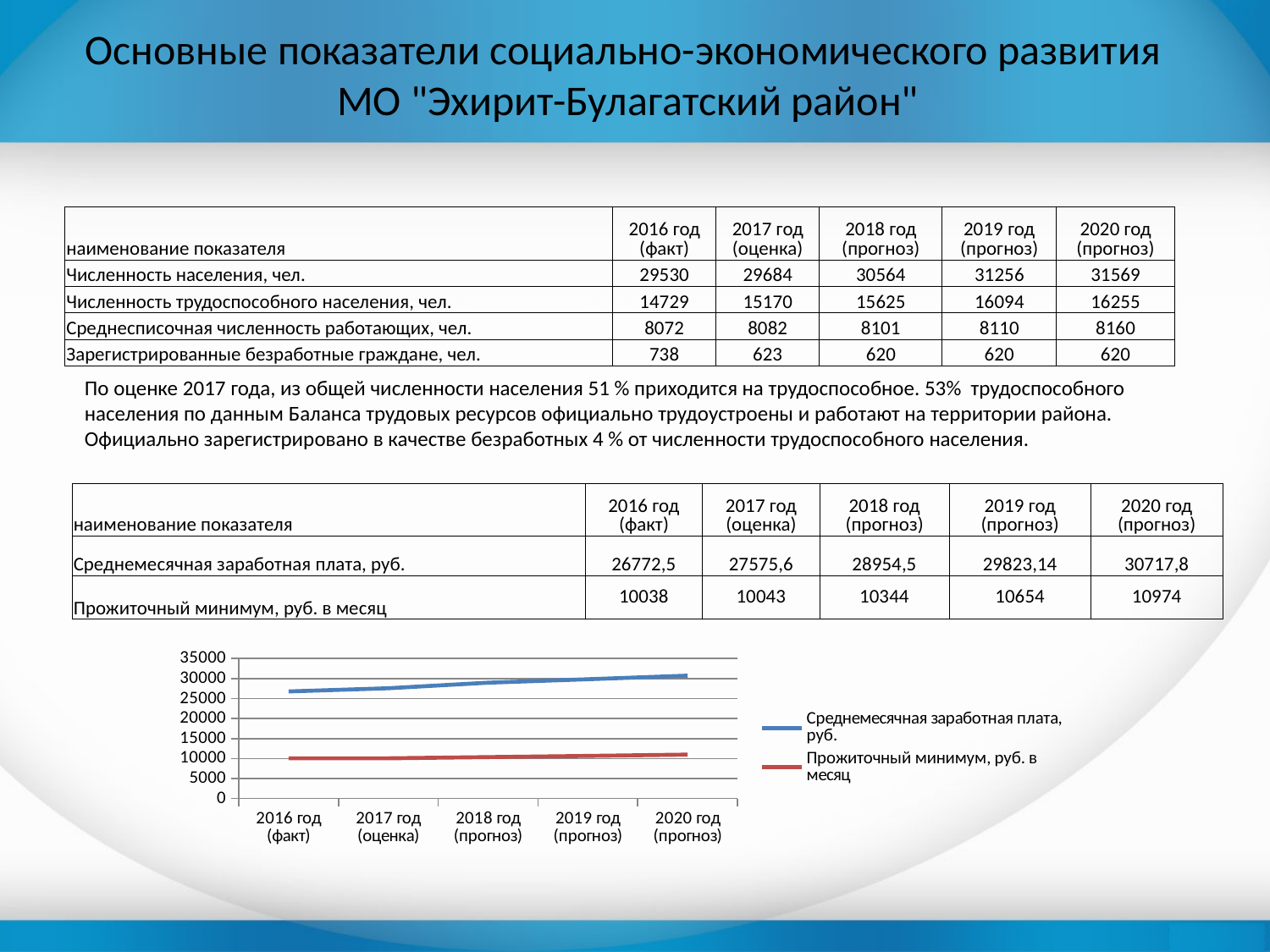
Is the value for Прожиточный минимум, руб. в месяц in 2016 год (факт) greater or less than 5000? greater Does the line for Прожиточный минимум, руб. в месяц rise or fall across the years shown? rise What is the highest value shown on the chart's y axis? 35000 In 2016 год (факт), which series has the larger value: Среднемесячная заработная плата, руб. or Прожиточный минимум, руб. в месяц? Среднемесячная заработная плата, руб. Is the value for Среднемесячная заработная плата, руб. in 2016 год (факт) greater or less than 25000? greater Is the value for Среднемесячная заработная плата, руб. in 2020 год (прогноз) greater or less than 35000? less How many series does the chart's legend list? 2 What kind of chart is shown at the bottom of the slide? line chart What colour is the line for Среднемесячная заработная плата, руб. in the chart? blue Does the line for Среднемесячная заработная плата, руб. rise or fall from 2016 год (факт) to 2020 год (прогноз)? rise How many year categories are shown along the x axis of the chart? 5